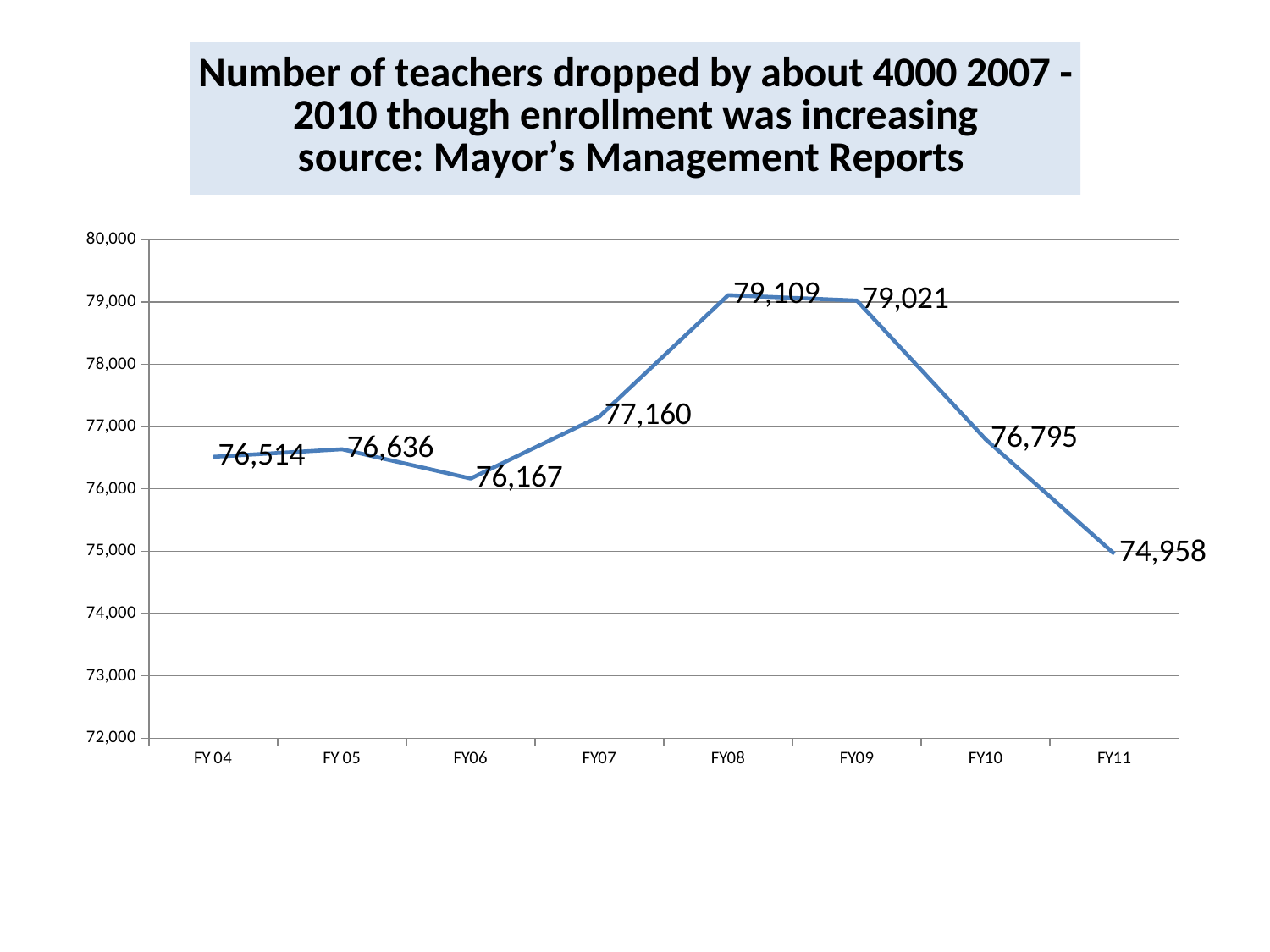
What is the difference between the values for FY08 and FY11? 4,151 What kind of chart is shown on the slide? line chart Which fiscal year has the highest value? FY08 Which is larger, the value for FY07 or the value for FY10? FY07 What is the value for FY 04? 76,514 Do the values rise or fall from FY09 to FY11? fall How many fiscal years are plotted on the chart? 8 What is the difference between the values for FY09 and FY10? 2,226 What is the value for FY11? 74,958 Is the value for FY06 greater or less than 77,000? less What is the value for FY08? 79,109 Which fiscal year has the lowest value? FY11